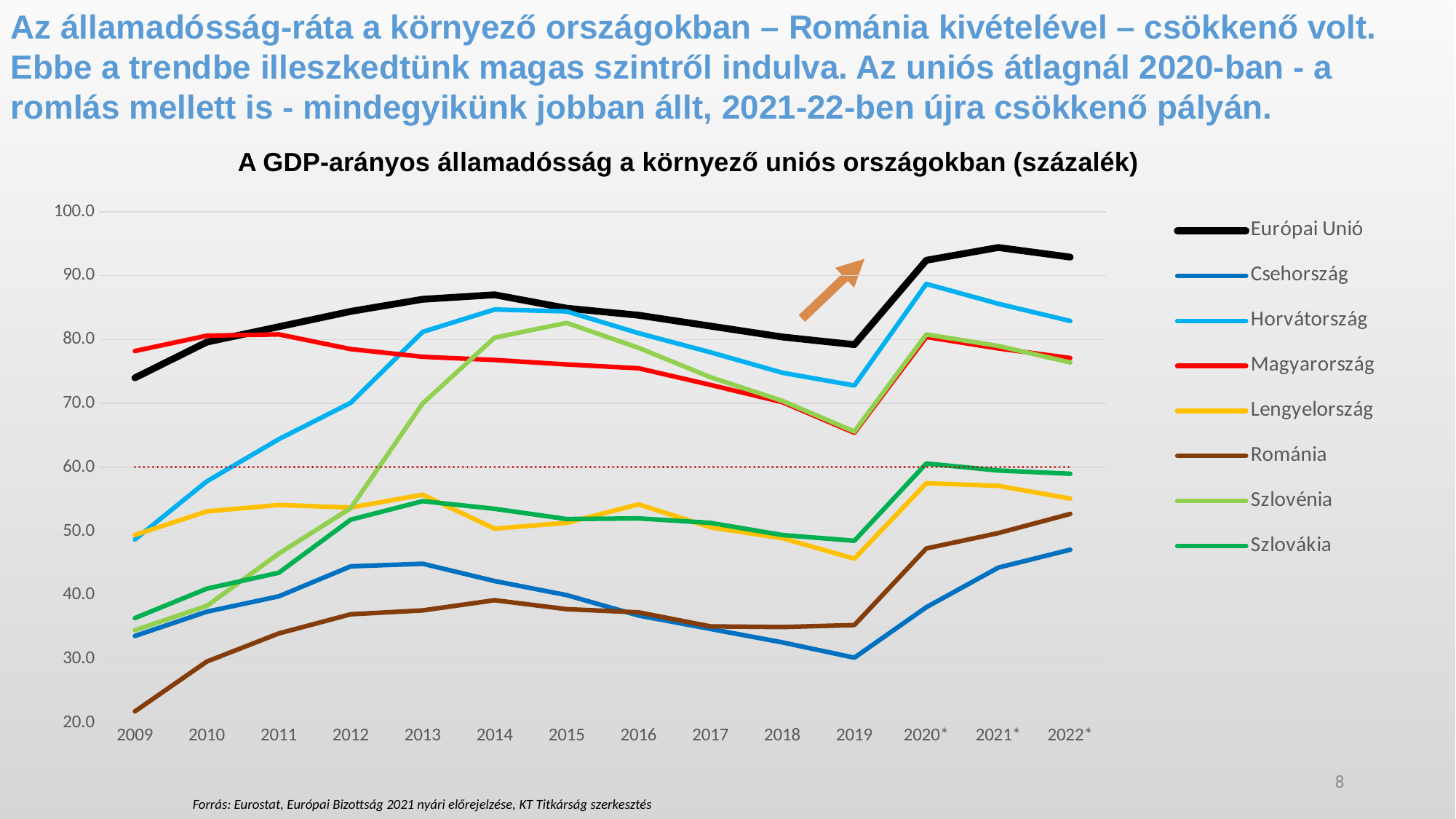
Which series has the lowest value in 2019? Csehország Which series has the lowest value in 2009? Románia Does the value for Románia rise or fall overall from 2009 to 2022*? rise What type of chart is shown on the slide? line chart How many years are shown on the x axis of the chart? 14 How many series does the legend list? 8 Which series has the highest value in 2009? Magyarország Which series has the highest value in 2022*? Európai Unió What is the title of the chart? A GDP-arányos államadósság a környező uniós országokban (százalék) Is the value for Európai Unió in 2021* greater or less than 90.0? greater In 2020*, which is larger: Horvátország or Magyarország? Horvátország Is the value for Románia in 2009 greater or less than 30.0? less